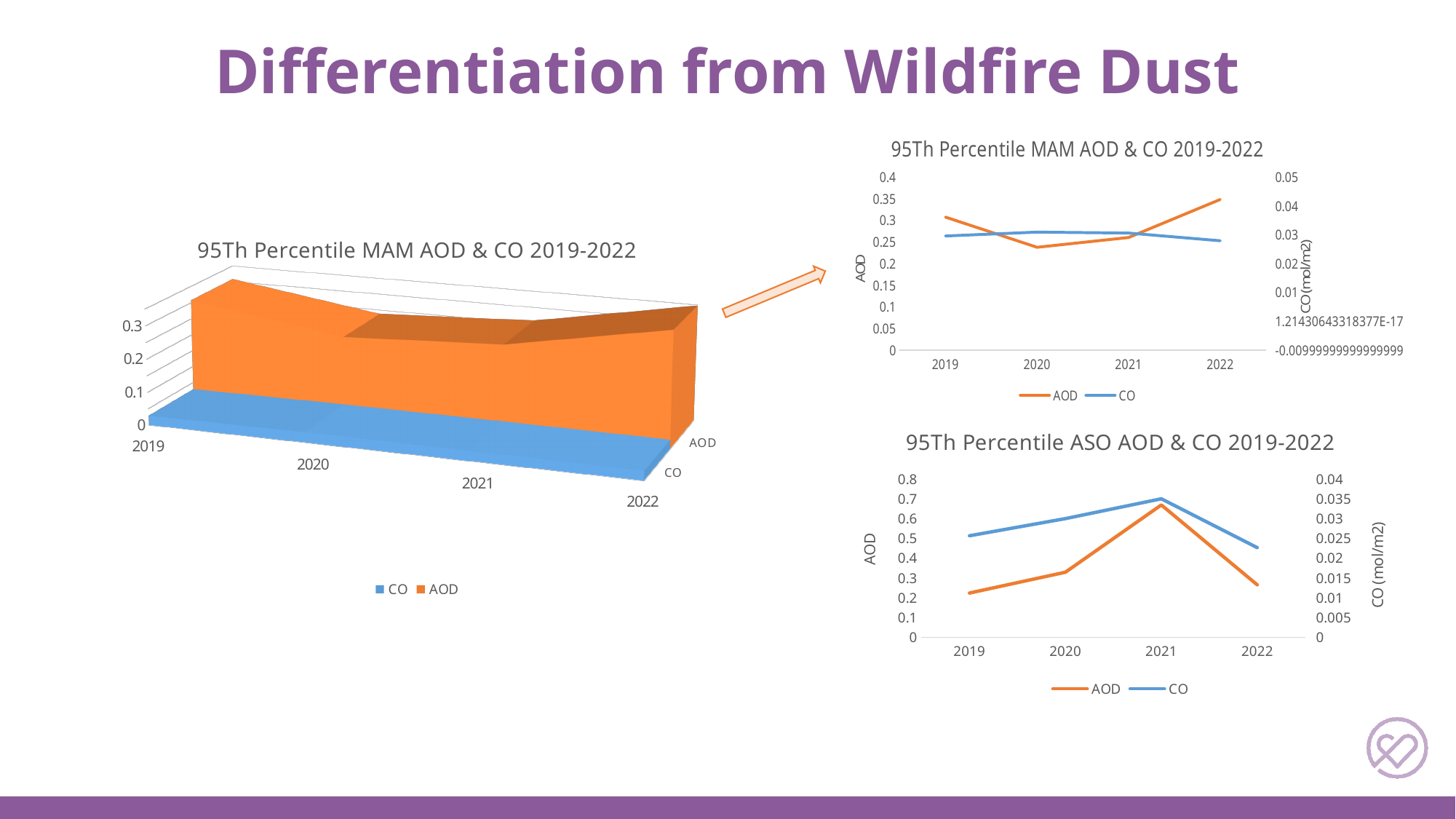
In the chart titled '95Th Percentile ASO AOD & CO 2019-2022', which year has the highest CO value? 2021 In the line chart titled '95Th Percentile MAM AOD & CO 2019-2022' at the top right, does the AOD value rise or fall from 2021 to 2022? rise How many series does the legend of the chart on the left of the slide list? 2 In the chart titled '95Th Percentile ASO AOD & CO 2019-2022', is the CO value for 2021 greater or less than 0.03? greater What kind of chart is the large chart on the left of the slide? 3D area chart In the line chart titled '95Th Percentile MAM AOD & CO 2019-2022' at the top right, which year has the lowest AOD value? 2020 In the chart titled '95Th Percentile ASO AOD & CO 2019-2022', which year has the highest AOD value? 2021 In the line chart titled '95Th Percentile MAM AOD & CO 2019-2022' at the top right, which year has the highest AOD value? 2022 In the chart titled '95Th Percentile ASO AOD & CO 2019-2022', is the AOD value for 2021 greater or less than 0.6? greater In the line chart titled '95Th Percentile MAM AOD & CO 2019-2022' at the top right, is the AOD value for 2022 greater or less than 0.3? greater In the line chart titled '95Th Percentile MAM AOD & CO 2019-2022' at the top right, is the AOD value for 2019 larger than the AOD value for 2020? Yes In the chart titled '95Th Percentile ASO AOD & CO 2019-2022', which year has the lowest AOD value? 2019